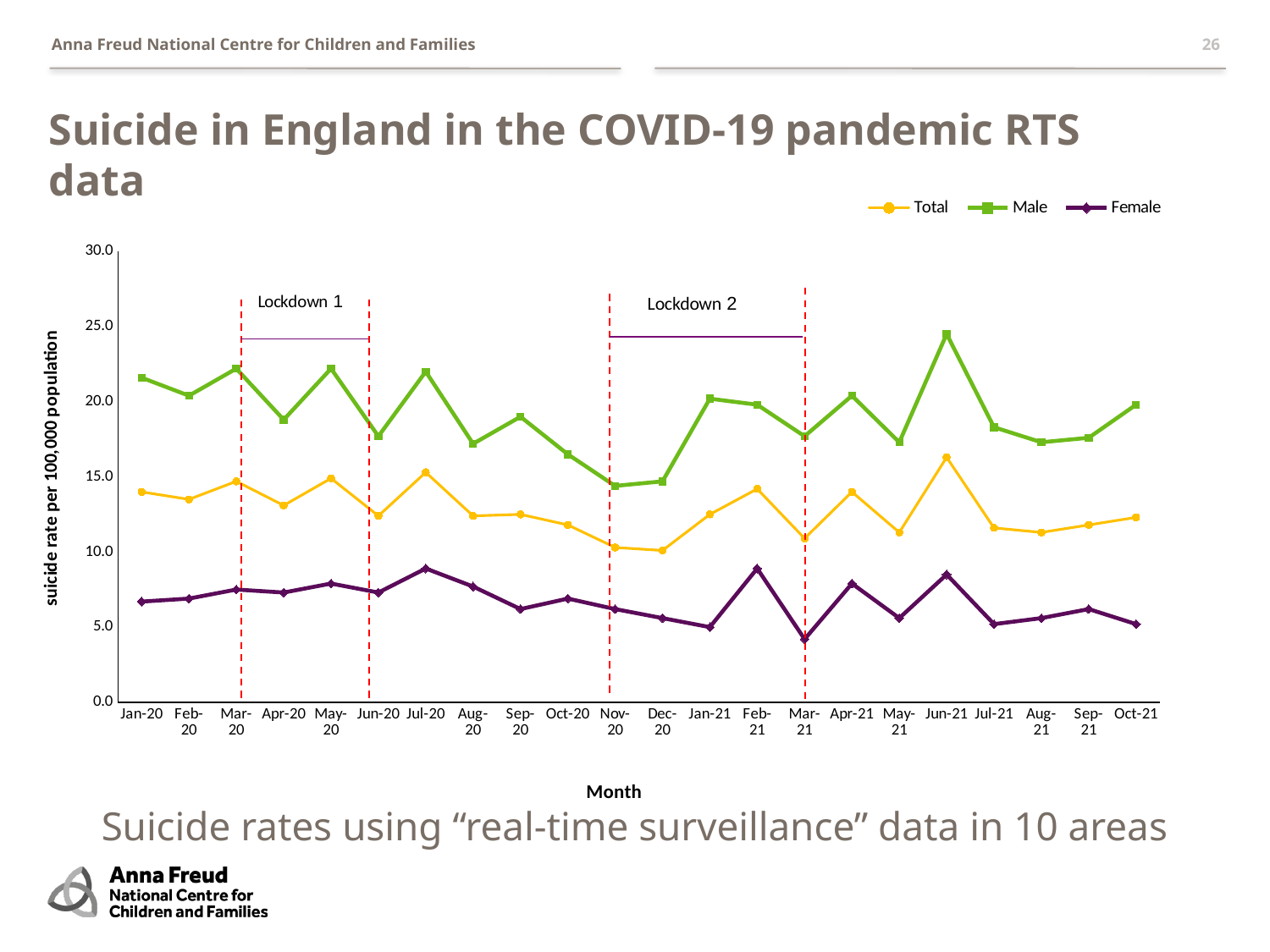
Is the Male value for Apr-20 greater or less than 20.0? less Is the Male value for Jun-21 greater or less than 20.0? greater What label is shown on the y axis? suicide rate per 100,000 population What kind of chart is shown on the slide? Line chart Is the Female value for Feb-21 greater or less than 10.0? less In which month does the Male series reach its highest value? Jun-21 How many series does the legend list? 3 Which series are listed in the legend? Total, Male, Female Which is larger in Jan-20, the Male value or the Female value? Male How many months are plotted along the x axis? 22 In which month does the Total series reach its highest value? Jun-21 In which month does the Female series reach its lowest value? Mar-21